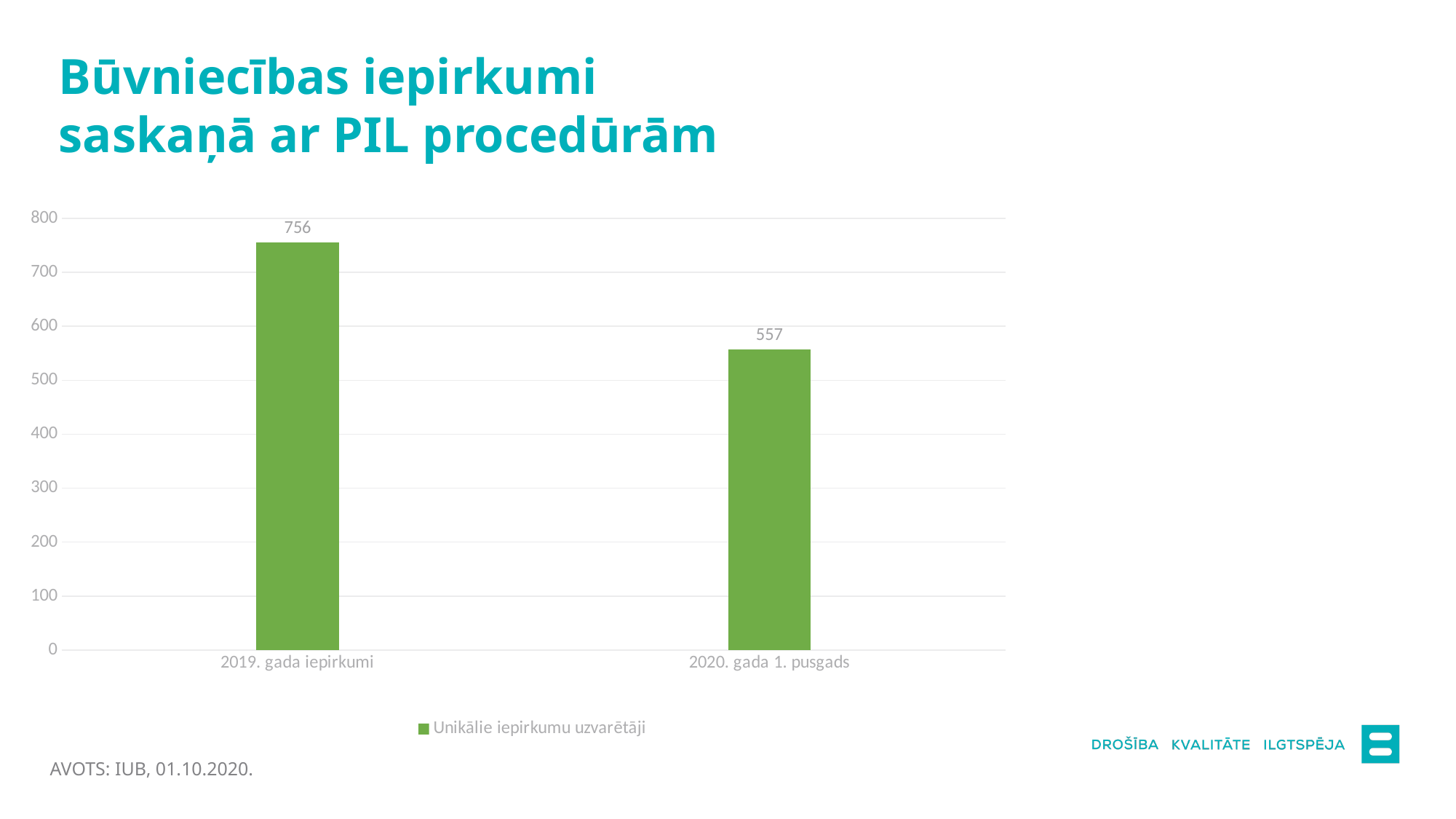
What is the name of the series shown in the legend? Unikālie iepirkumu uzvarētāji How many categories are shown on the x axis? 2 Which is larger, the value for 2019. gada iepirkumi or the value for 2020. gada 1. pusgads? 2019. gada iepirkumi What is the value for 2019. gada iepirkumi? 756 Is the value for 2020. gada 1. pusgads greater or less than 600? less What kind of chart is shown on the slide? bar chart Is the value for 2019. gada iepirkumi greater or less than 700? greater Which category has the lowest value? 2020. gada 1. pusgads What is the value for 2020. gada 1. pusgads? 557 How many series does the legend list? 1 Which category has the highest value? 2019. gada iepirkumi What is the difference between the values for 2019. gada iepirkumi and 2020. gada 1. pusgads? 199